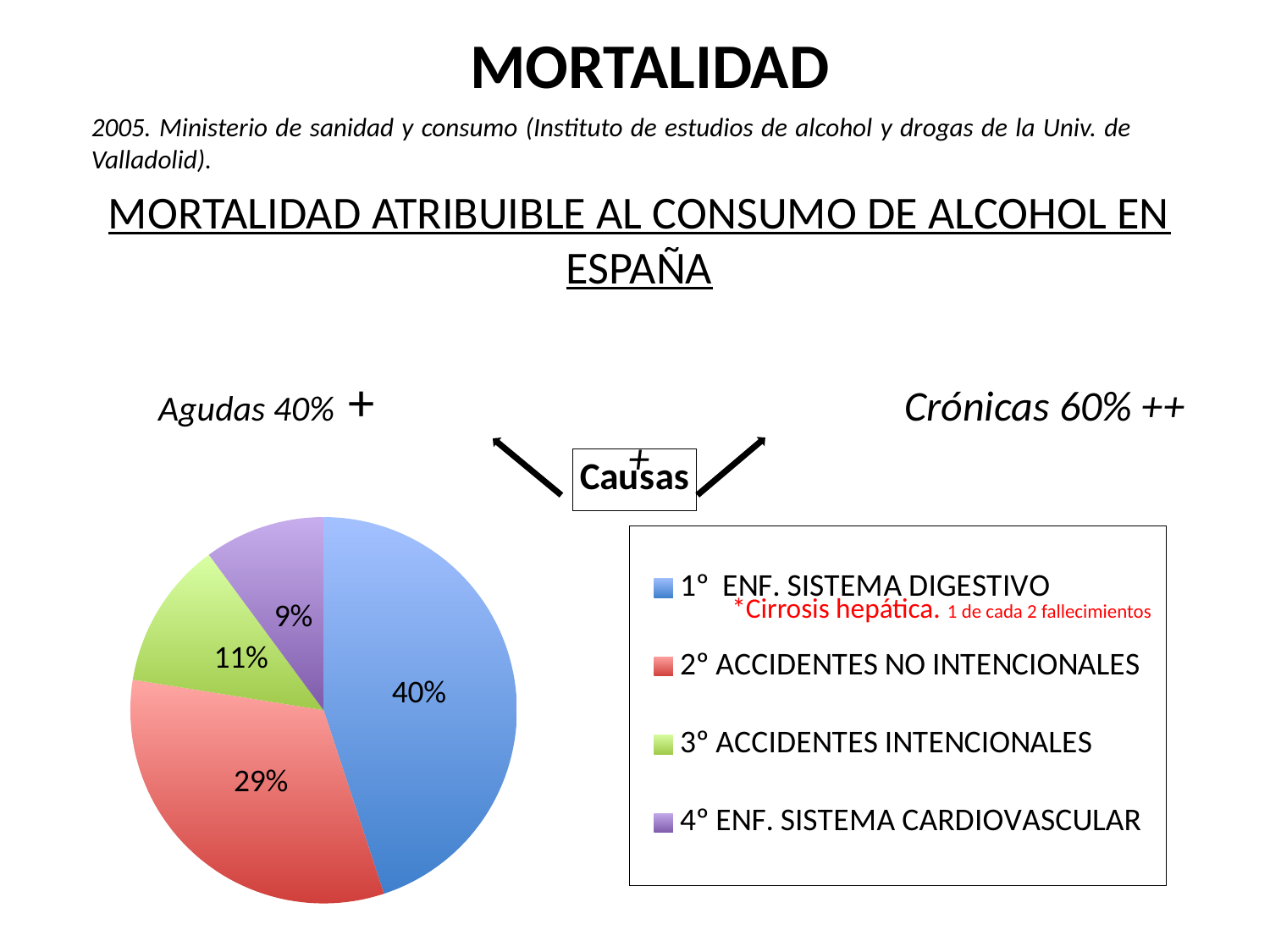
Which is larger, the slice for 3º ACCIDENTES INTENCIONALES or the slice for 4º ENF. SISTEMA CARDIOVASCULAR? 3º ACCIDENTES INTENCIONALES What colour is the slice for 1º ENF. SISTEMA DIGESTIVO? blue What share of the pie does 4º ENF. SISTEMA CARDIOVASCULAR represent? 9% What share of the pie does 3º ACCIDENTES INTENCIONALES represent? 11% How many categories does the pie chart have? 4 What is the difference in percentage points between the slices for 1º ENF. SISTEMA DIGESTIVO and 2º ACCIDENTES NO INTENCIONALES? 11 What share of the pie does 2º ACCIDENTES NO INTENCIONALES represent? 29% What share of the pie does 1º ENF. SISTEMA DIGESTIVO represent? 40% Which category has the largest slice of the pie? 1º ENF. SISTEMA DIGESTIVO What colour is the slice for 2º ACCIDENTES NO INTENCIONALES? red Which category has the smallest slice of the pie? 4º ENF. SISTEMA CARDIOVASCULAR What kind of chart is shown on the slide? pie chart